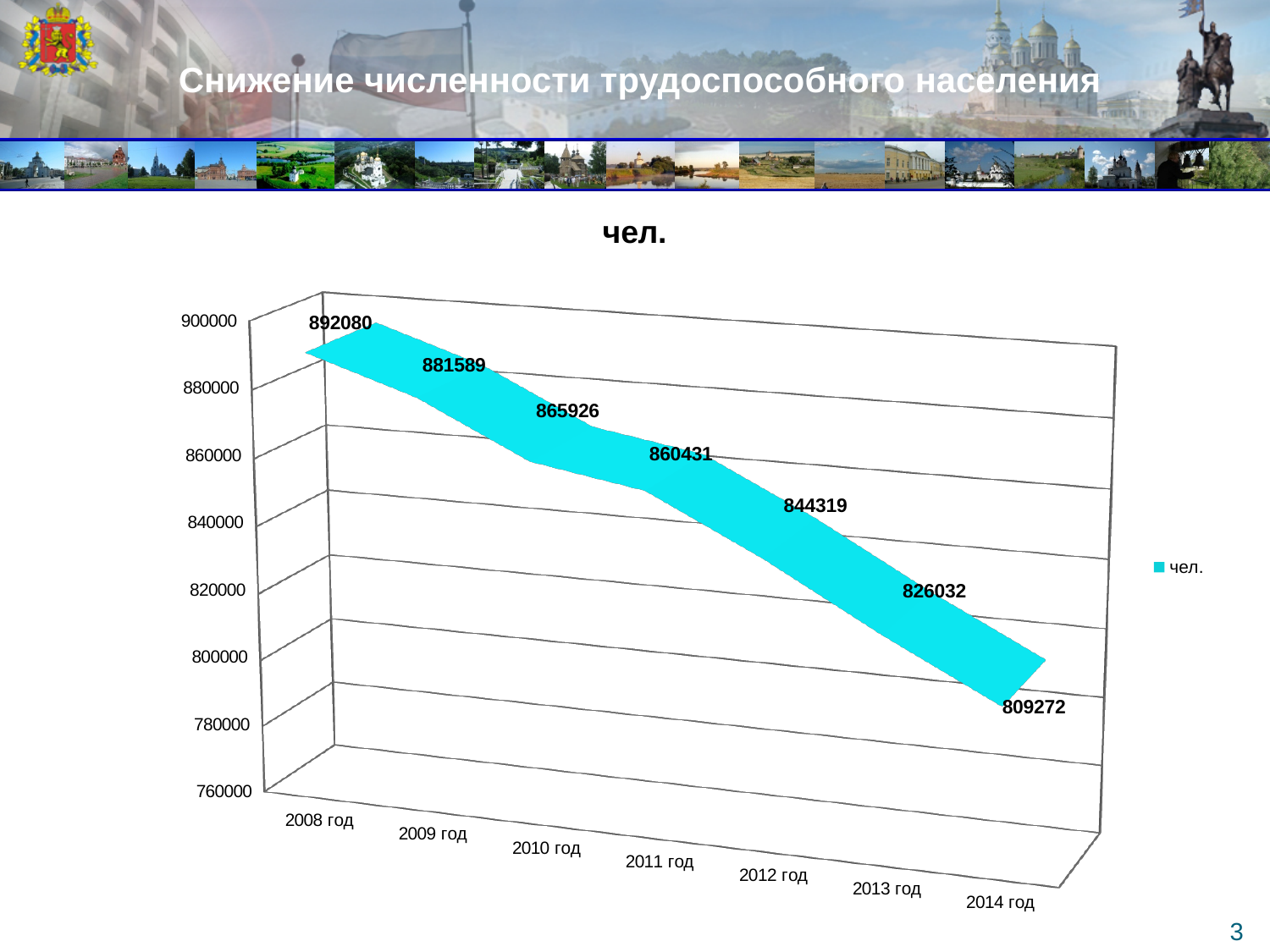
Do the values rise or fall from 2008 год to 2014 год? fall Which year has the lowest value? 2014 год Which is larger, the value for 2009 год or the value for 2010 год? 2009 год What kind of chart is shown on the slide? line chart What is the difference between the values for 2008 год and 2014 год? 82808 What is the value for 2008 год? 892080 How many series does the legend list? 1 What is the value for 2011 год? 860431 What is the difference between the values for 2012 год and 2013 год? 18287 What is the value for 2014 год? 809272 Which year has the highest value? 2008 год How many years are plotted on the chart? 7